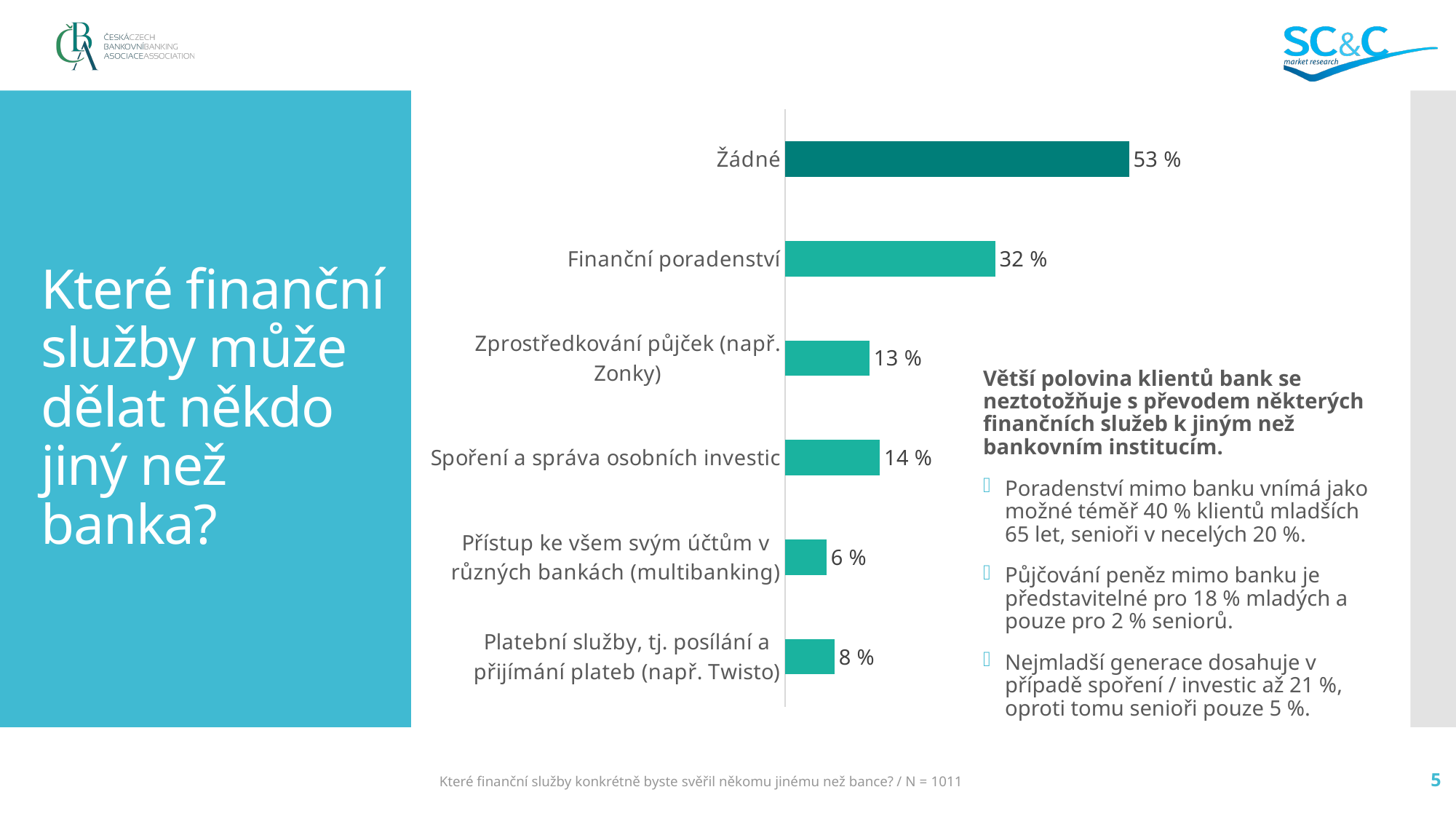
Which category has the lowest value? Přístup ke všem svým účtům v různých bankách (multibanking) What is the value for Spoření a správa osobních investic? 14 % What is the value for Platební služby, tj. posílání a přijímání plateb (např. Twisto)? 8 % What is the value for Žádné? 53 % What is the value for Zprostředkování půjček (např. Zonky)? 13 % What is the value for Finanční poradenství? 32 % What kind of chart is shown on the slide? Bar chart What is the difference between the values for Žádné and Finanční poradenství? 21 % What is the value for Přístup ke všem svým účtům v různých bankách (multibanking)? 6 % How many categories are shown in the chart? 6 Which is larger, the value for Spoření a správa osobních investic or the value for Zprostředkování půjček (např. Zonky)? Spoření a správa osobních investic Which category has the highest value? Žádné